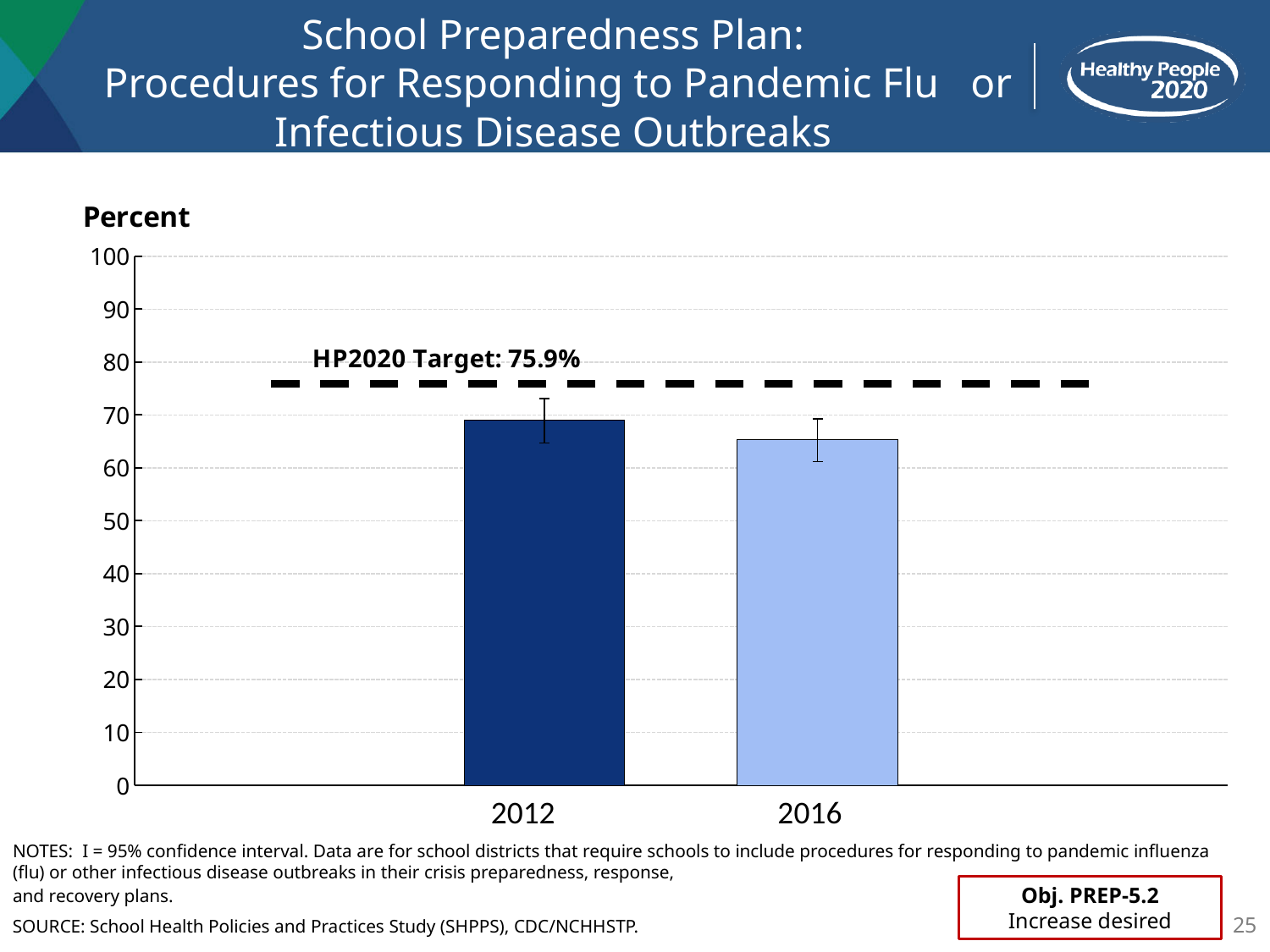
Which year has the lowest value in the chart? 2016 Is the value for 2016 greater or less than 70? less Is the value for 2016 greater or less than 60? greater How many years are plotted as bars in the chart? 2 Which year has the higher bar, 2012 or 2016? 2012 What is the HP2020 Target value shown on the chart? 75.9% Do the values rise or fall from 2012 to 2016? fall Which year has the highest value in the chart? 2012 What is the label on the vertical axis of the chart? Percent Which objective number is shown in the box at the bottom right of the slide? Obj. PREP-5.2 Is the value for 2012 greater or less than 60? greater What kind of chart is shown on the slide? bar chart